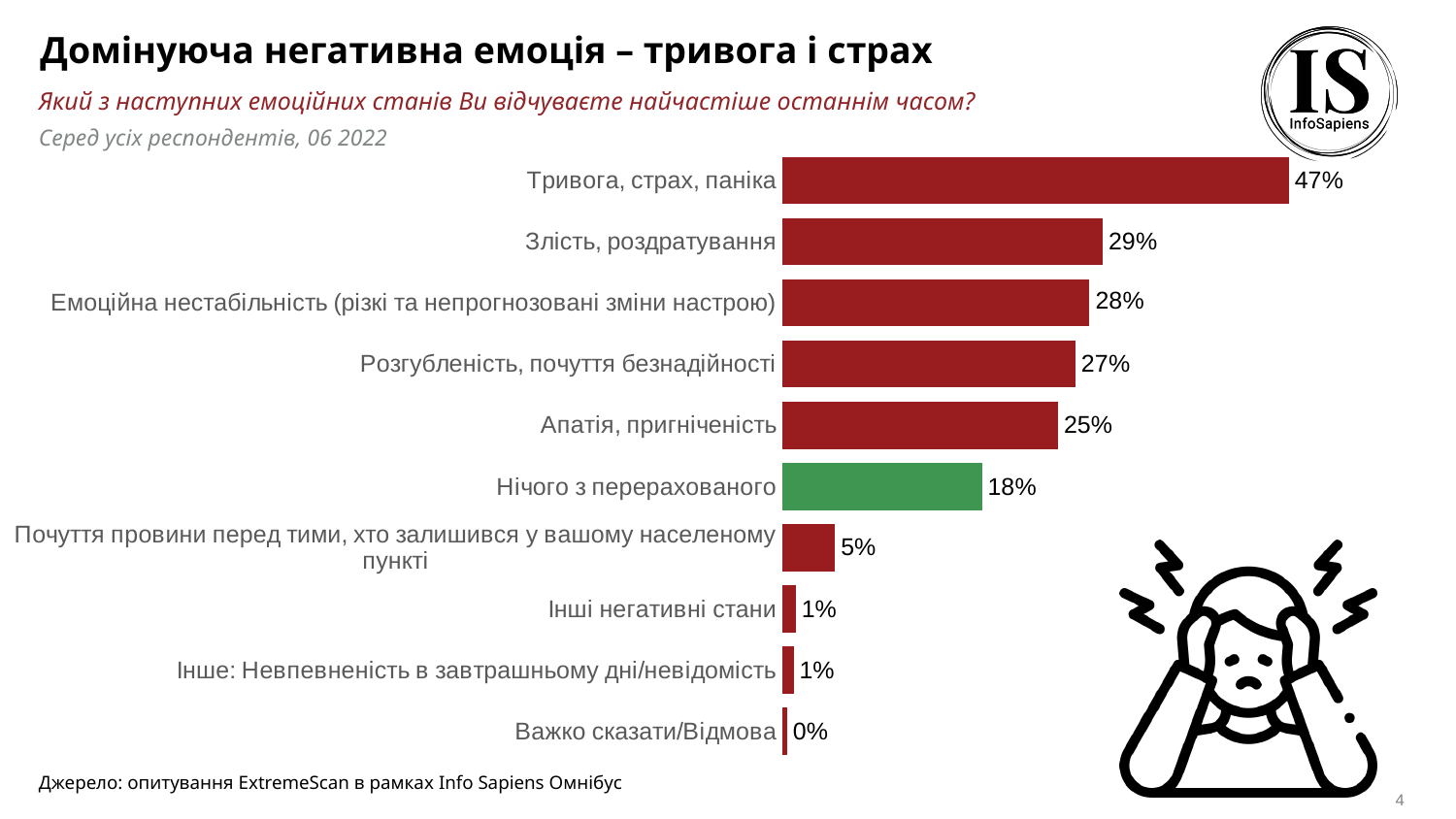
What is the value for "Почуття провини перед тими, хто залишився у вашому населеному пункті"? 5% What is the value for "Апатія, пригніченість"? 25% How many categories are shown in the chart? 10 Which category has the highest value? Тривога, страх, паніка What is the value for "Емоційна нестабільність (різкі та непрогнозовані зміни настрою)"? 28% Which category's bar is coloured green rather than red? Нічого з перерахованого Which category has the lowest value? Важко сказати/Відмова Which is larger: the value for "Розгубленість, почуття безнадійності" or the value for "Нічого з перерахованого"? Розгубленість, почуття безнадійності What kind of chart is shown on the slide? Bar chart What is the value for "Нічого з перерахованого"? 18% What is the value for "Тривога, страх, паніка"? 47% What is the difference between the values for "Тривога, страх, паніка" and "Злість, роздратування"? 18%